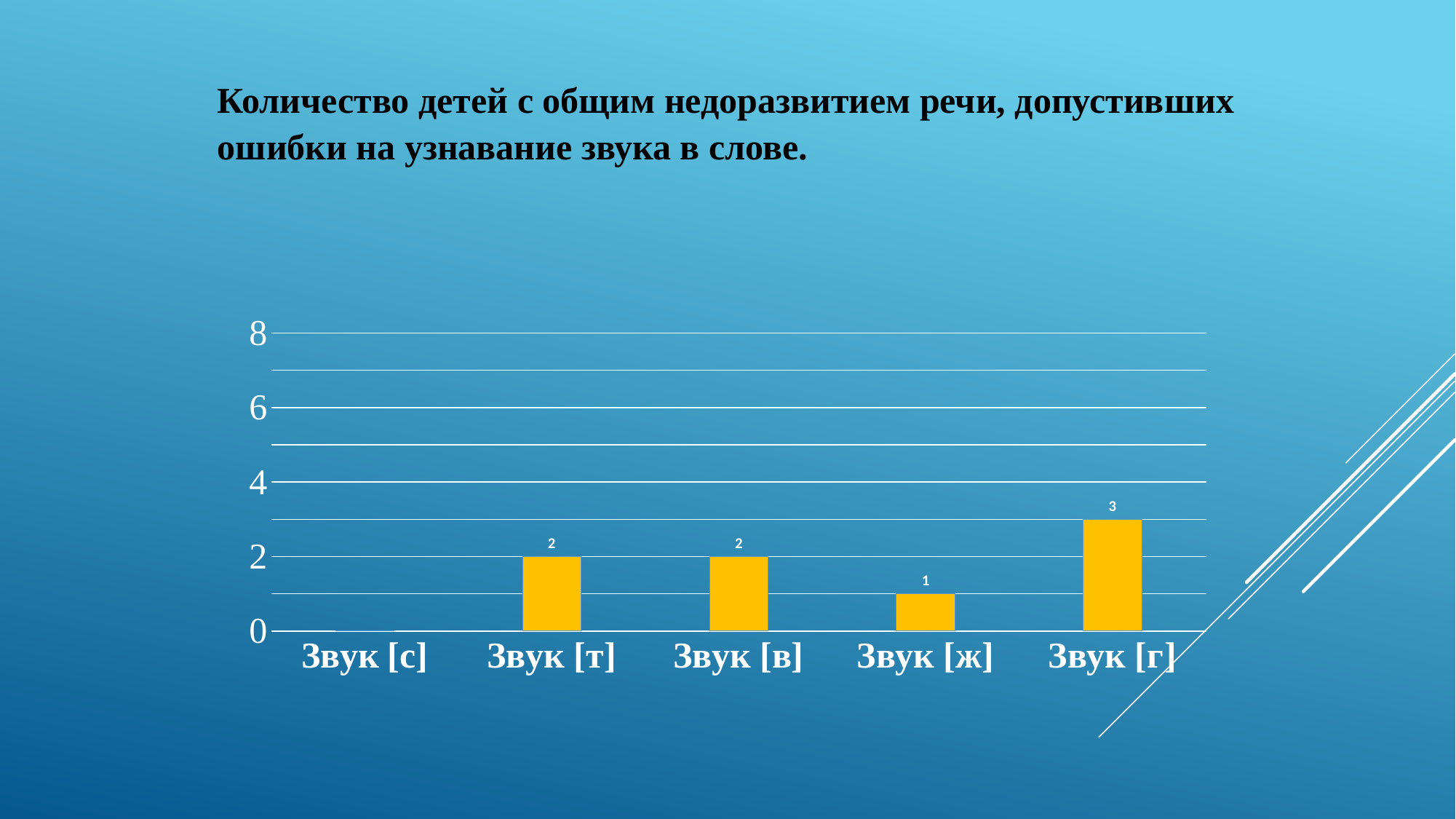
What is the value for Звук [т]? 2 What is the value for Звук [ж]? 1 What is the value for Звук [г]? 3 Which category has the highest value? Звук [г] Which is larger, the value for Звук [г] or the value for Звук [т]? Звук [г] What is the value for Звук [в]? 2 What is the difference between the values for Звук [г] and Звук [ж]? 2 What colour are the bars in the chart? yellow What is the title of the chart? Количество детей с общим недоразвитием речи, допустивших ошибки на узнавание звука в слове. How many categories are shown on the x axis? 5 Is the value for Звук [г] greater or less than 4? less What kind of chart is shown on the slide? bar chart